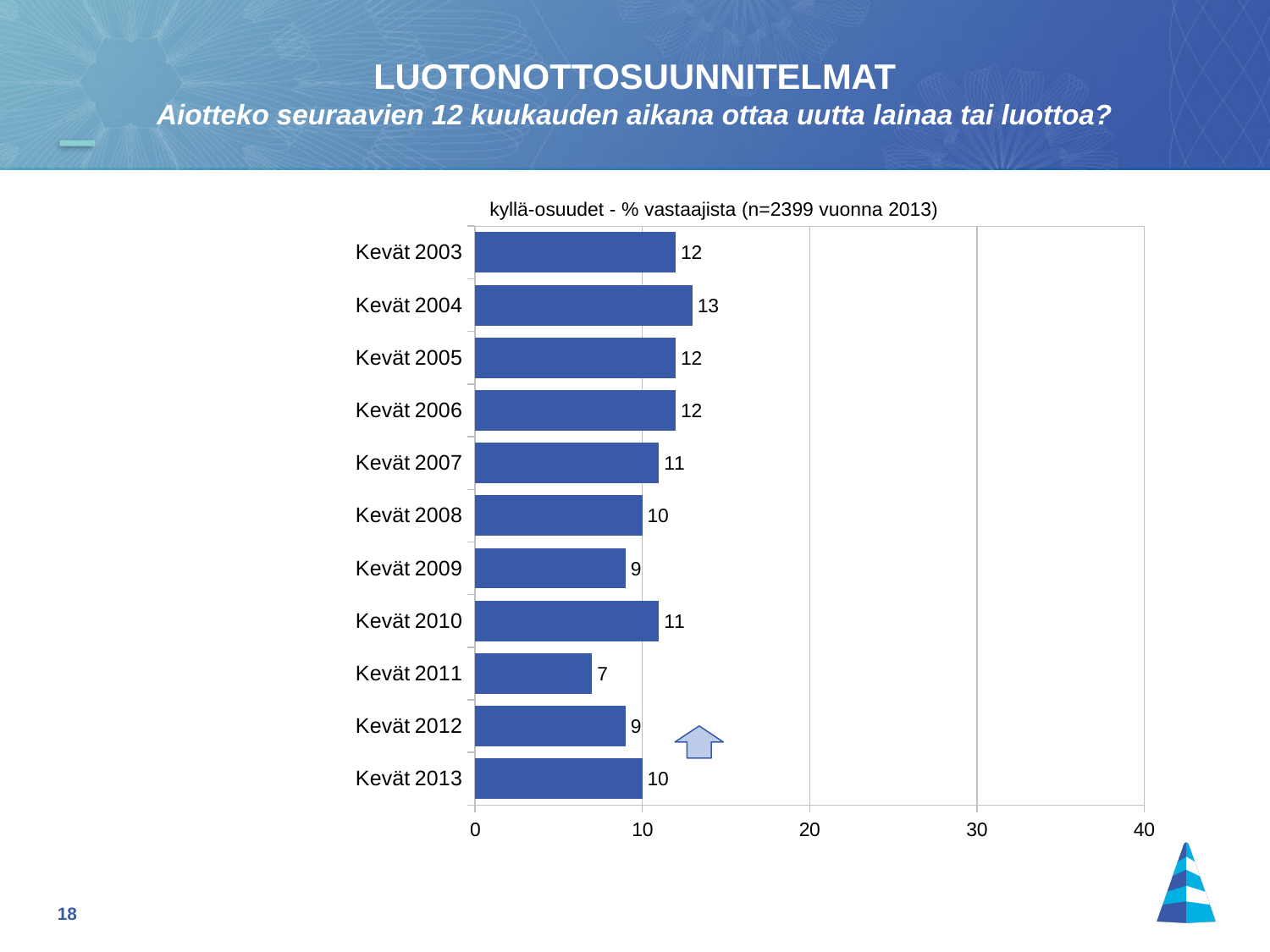
Which category has the lowest value? Kevät 2011 Which is larger, the value for Kevät 2007 or the value for Kevät 2009? Kevät 2007 What kind of chart is shown on the slide? bar chart How many categories are shown in the chart? 11 Is the value for Kevät 2003 greater or less than 10? greater What is the difference between the values for Kevät 2004 and Kevät 2011? 6 What is the value for Kevät 2013? 10 What is the highest value shown on the horizontal axis? 40 Which category has the highest value? Kevät 2004 What is the value for Kevät 2004? 13 What is the chart's title? kyllä-osuudet - % vastaajista (n=2399 vuonna 2013) What is the value for Kevät 2011? 7